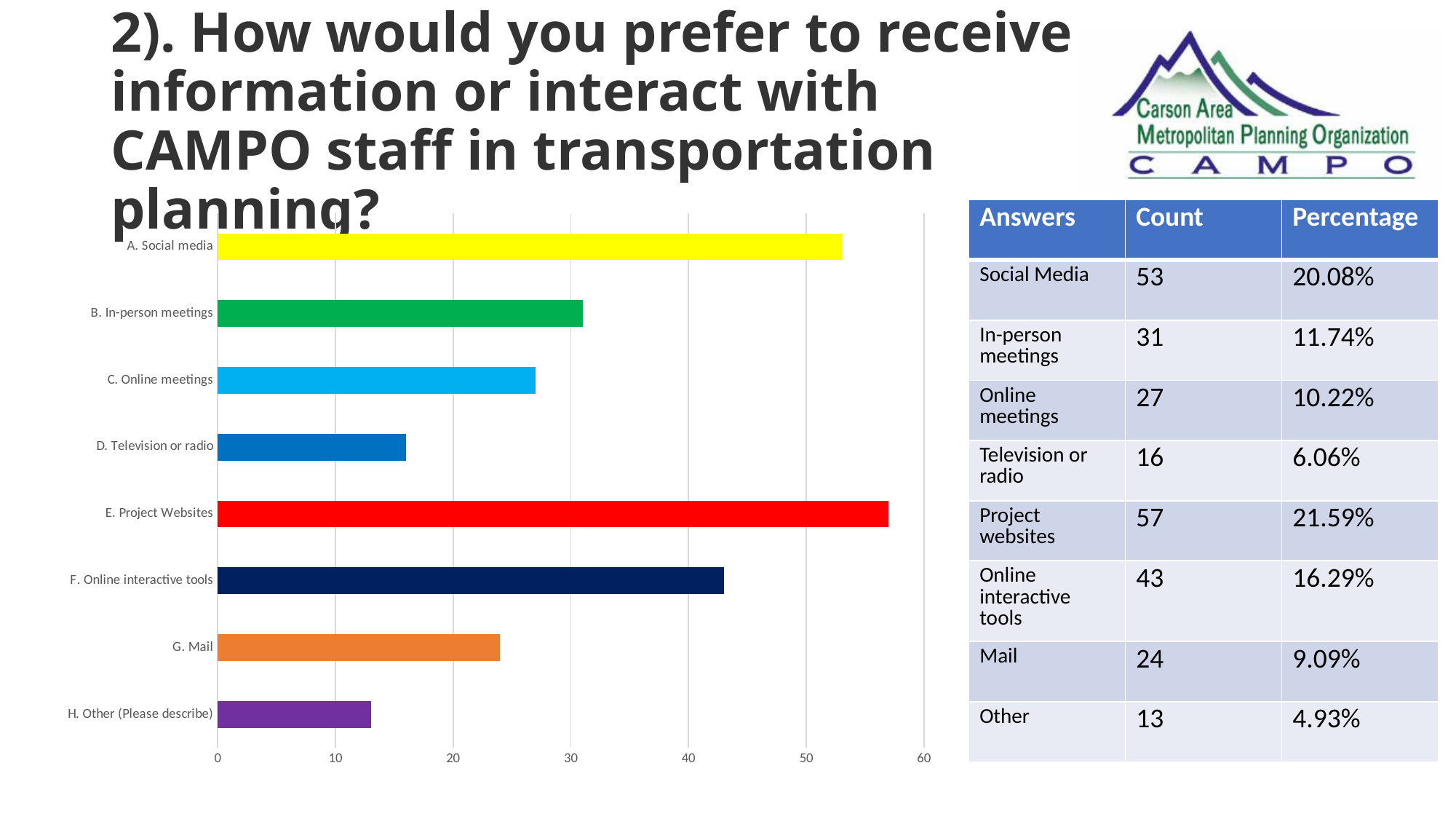
Is the value for F. Online interactive tools greater or less than 40? greater Which category has the highest value in the bar chart? E. Project Websites What is the difference between the counts for Project websites and Social Media? 4 What colour is the bar for E. Project Websites? red What is the count for Online interactive tools shown on the slide? 43 Is the value for D. Television or radio greater or less than 20? less What is the count for Social Media shown on the slide? 53 Which category has the lowest value in the bar chart? H. Other (Please describe) What percentage is shown for Project websites? 21.59% What kind of chart is shown on the slide? bar chart Which is larger, the value for B. In-person meetings or the value for C. Online meetings? B. In-person meetings How many categories does the bar chart show? 8